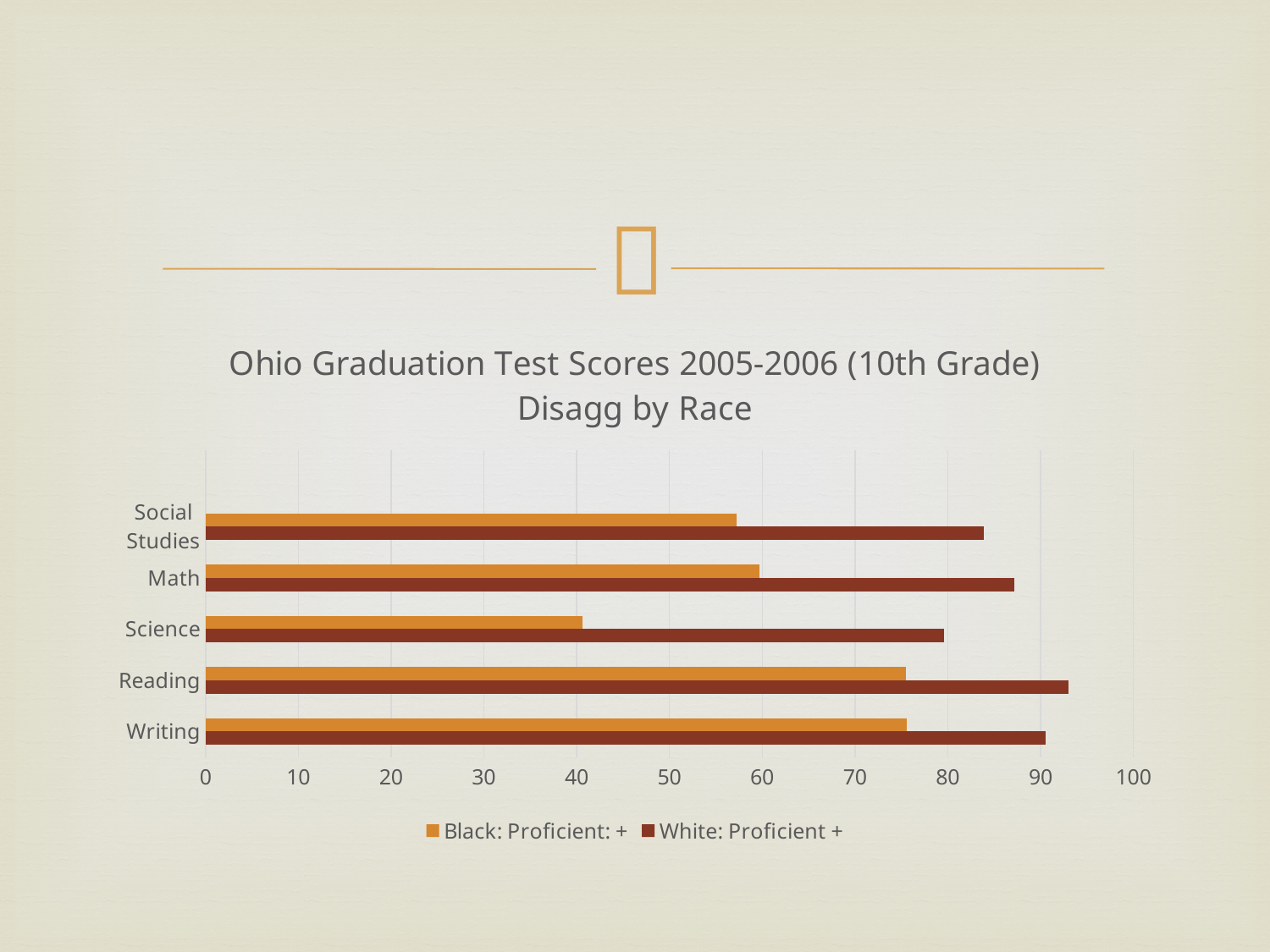
What kind of chart is shown on the slide? bar chart Is the White: Proficient + value for Reading greater or less than 90? greater What is the title of the chart? Ohio Graduation Test Scores 2005-2006 (10th Grade) Disagg by Race For the Black: Proficient: + series, which is larger: Reading or Science? Reading How many subject categories are shown on the chart? 5 For Writing, which series has the larger value: Black: Proficient: + or White: Proficient +? White: Proficient + Which subject has the lowest value for the White: Proficient + series? Science Is the Black: Proficient: + value for Social Studies greater or less than 50? greater Is the White: Proficient + value for Math greater or less than 80? greater Which subject has the lowest value for the Black: Proficient: + series? Science How many series does the legend list? 2